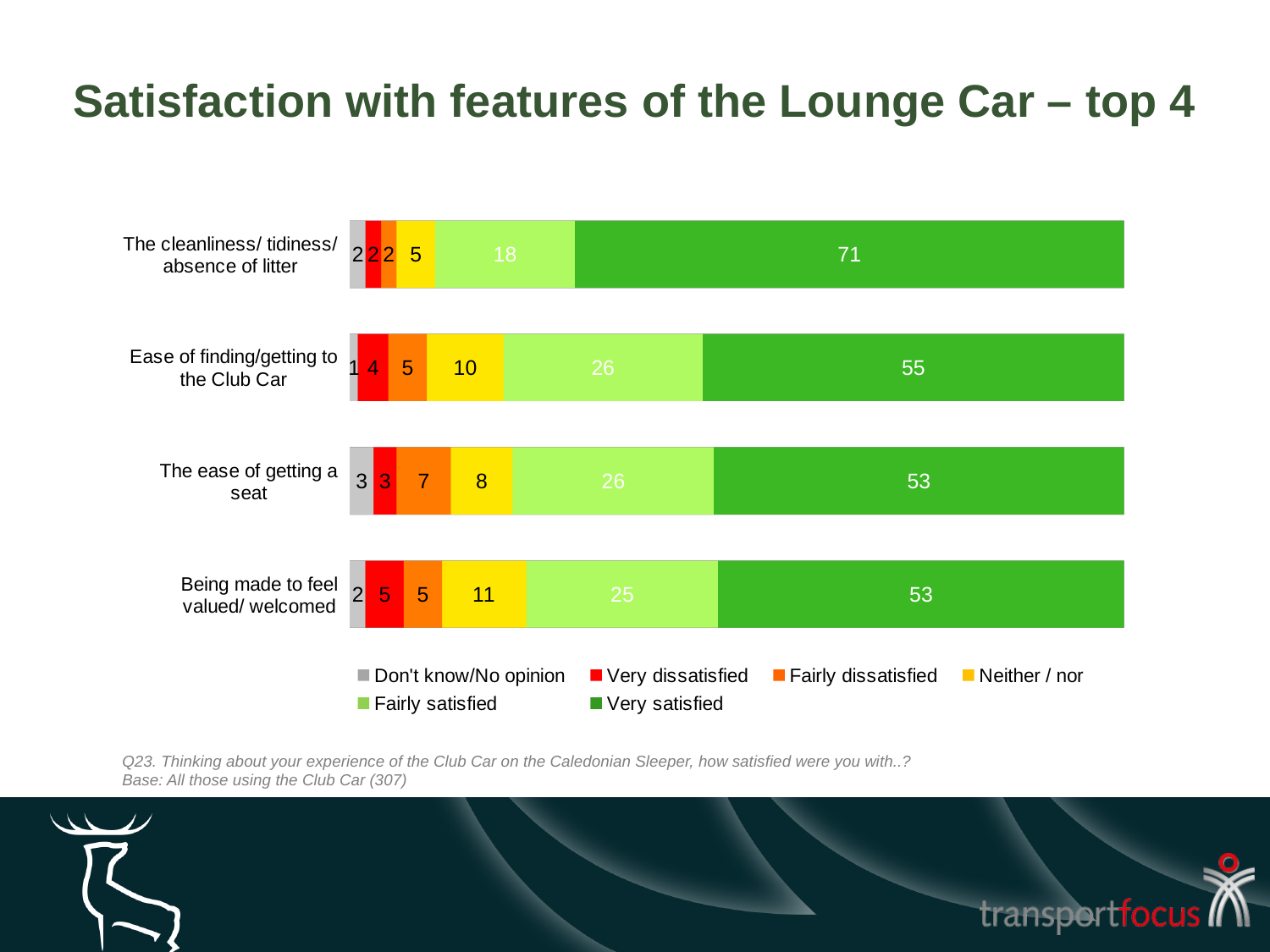
What kind of chart is shown on the slide? Stacked bar chart Which is larger: the 'Neither / nor' value for 'Being made to feel valued/ welcomed' or for 'The ease of getting a seat'? Being made to feel valued/ welcomed What is the 'Neither / nor' value for 'Being made to feel valued/ welcomed'? 11 How many categories are shown on the chart? 4 What is the 'Fairly satisfied' value for 'Ease of finding/getting to the Club Car'? 26 What is the 'Very satisfied' value for 'The cleanliness/ tidiness/ absence of litter'? 71 Which category has the lowest 'Fairly satisfied' value? The cleanliness/ tidiness/ absence of litter What is the 'Fairly dissatisfied' value for 'The ease of getting a seat'? 7 How many series does the legend list? 6 What is the difference between the 'Very satisfied' values for 'The cleanliness/ tidiness/ absence of litter' and 'Ease of finding/getting to the Club Car'? 16 Which category has the highest 'Very satisfied' value? The cleanliness/ tidiness/ absence of litter Which colour represents 'Very dissatisfied' in the legend? Red